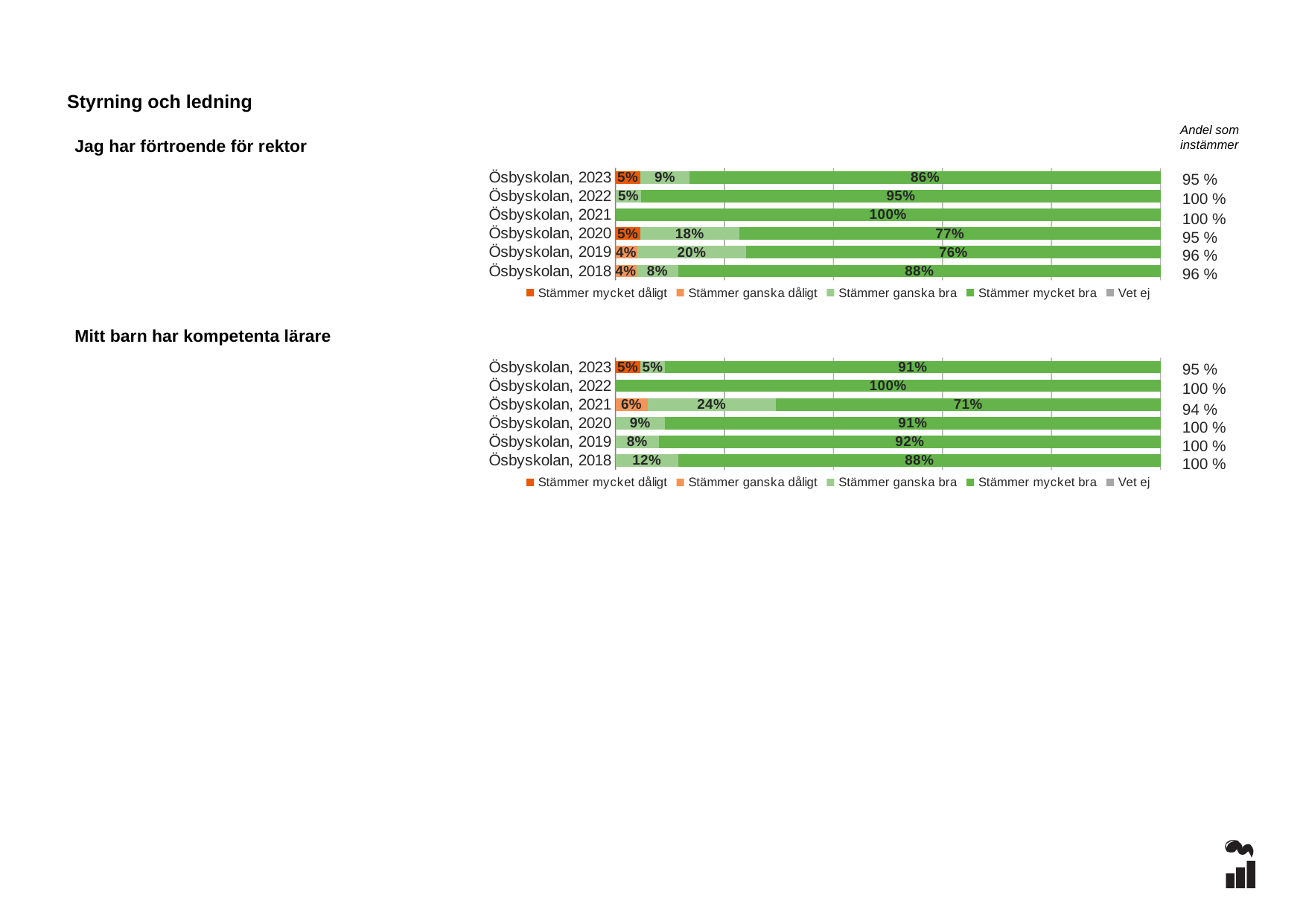
In the chart 'Mitt barn har kompetenta lärare', what is the 'Stämmer mycket bra' value for Ösbyskolan, 2019? 92% In the chart 'Jag har förtroende för rektor', which year has the highest 'Stämmer mycket bra' value? Ösbyskolan, 2021 In the chart 'Mitt barn har kompetenta lärare', is the 'Stämmer mycket bra' value larger for Ösbyskolan, 2018 or Ösbyskolan, 2020? Ösbyskolan, 2020 In the chart 'Jag har förtroende för rektor', which year has the lowest 'Stämmer mycket bra' value? Ösbyskolan, 2019 In the chart 'Jag har förtroende för rektor', what is the 'Stämmer mycket bra' value for Ösbyskolan, 2023? 86% In the chart 'Mitt barn har kompetenta lärare', what is the 'Stämmer ganska bra' value for Ösbyskolan, 2021? 24% In the chart 'Mitt barn har kompetenta lärare', how many categories (years) are shown? 6 What kind of chart is used for 'Mitt barn har kompetenta lärare'? Stacked bar chart In the chart 'Jag har förtroende för rektor', what is the difference between the 'Stämmer mycket bra' values for Ösbyskolan, 2018 and Ösbyskolan, 2020? 11% In the chart 'Mitt barn har kompetenta lärare', which year has the lowest 'Stämmer mycket bra' value? Ösbyskolan, 2021 In the chart 'Jag har förtroende för rektor', how many series does the legend list? 5 In the chart 'Jag har förtroende för rektor', what is the 'Stämmer ganska bra' value for Ösbyskolan, 2019? 20%